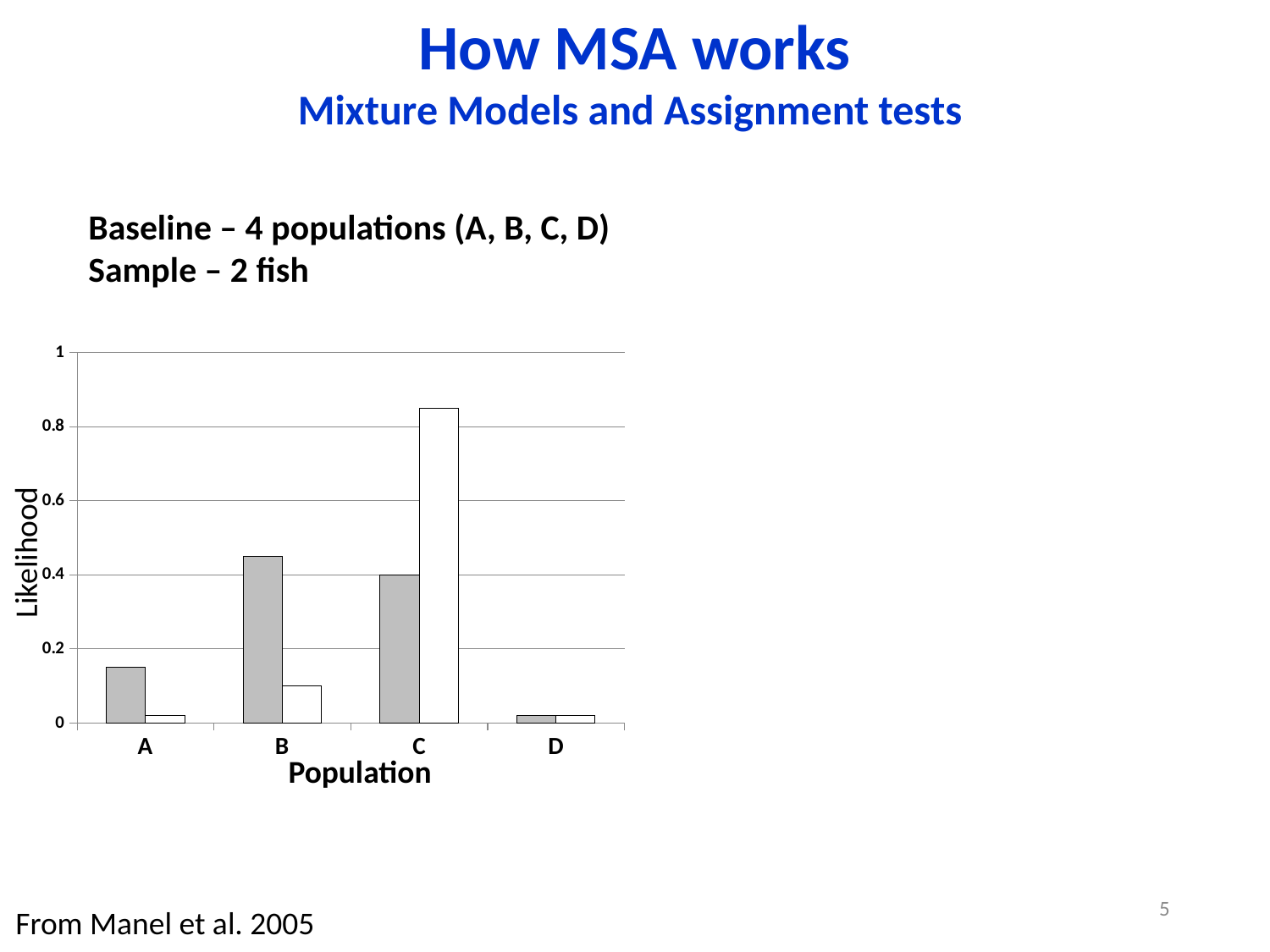
How many populations are shown on the x axis of the chart? 4 What is the label of the y axis of the chart? Likelihood What is the label of the x axis of the chart? Population Which population has the shortest gray bar? D Is the gray bar for population A greater or less than 0.2? less Is the white bar for population C greater or less than 0.6? greater What kind of chart is shown on the slide? bar chart Which is taller, the gray bar for population A or the gray bar for population B? the gray bar for population B For population C, which bar is taller, the gray bar or the white bar? the white bar Is the white bar for population B greater or less than 0.2? less Which population has the tallest white bar? C